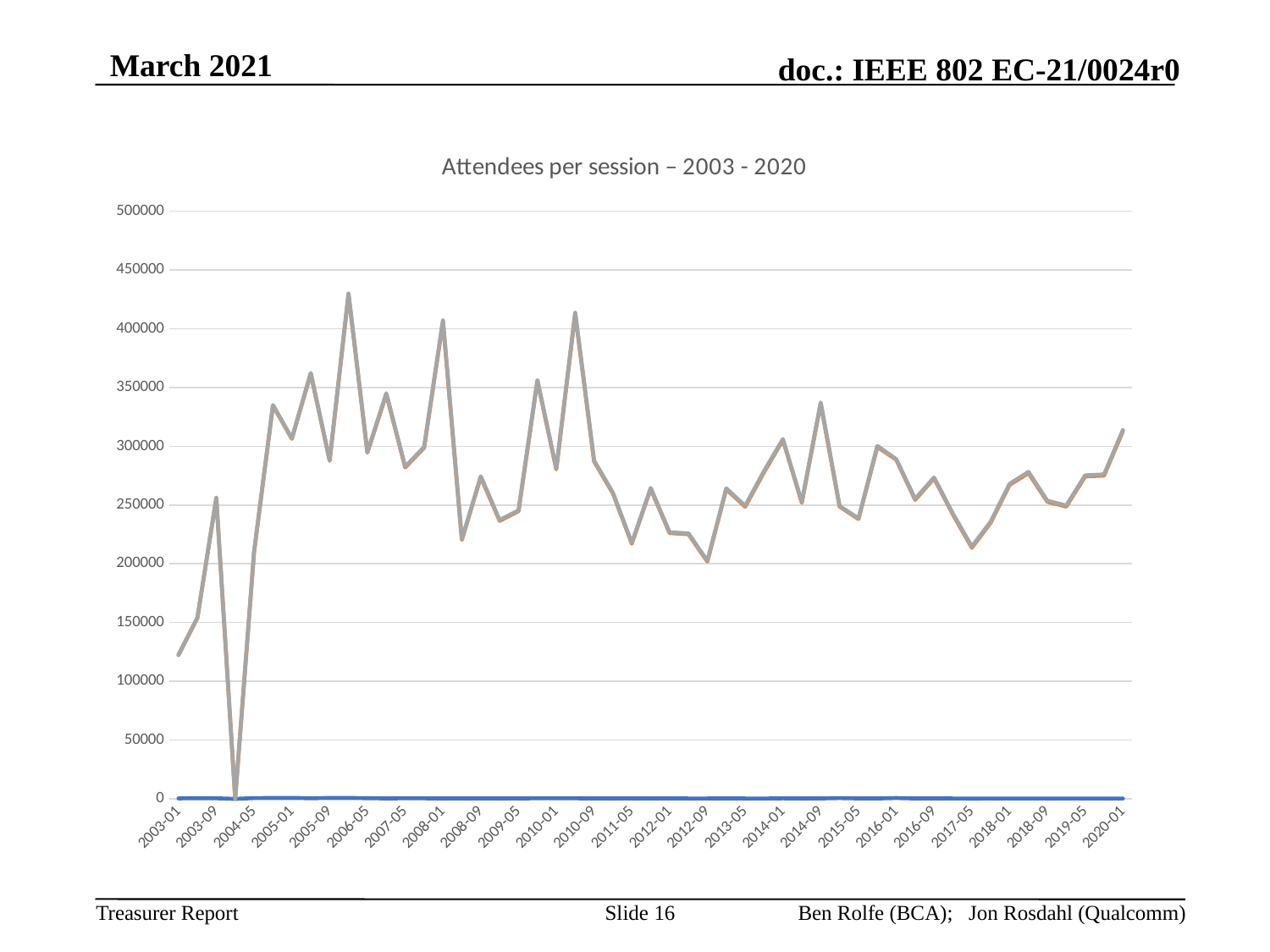
Do the values rise or fall from 2016-01 to 2017-05? fall Is the value for 2014-09 greater or less than 300000? greater Is the value for 2003-09 greater or less than 200000? greater What kind of chart is shown on the slide? line chart What is the title of the chart? Attendees per session – 2003 - 2020 What is the highest value shown on the y axis? 500000 Is the highest value on the chart greater or less than 400000? greater What is the lowest value reached by the line on the chart? 0